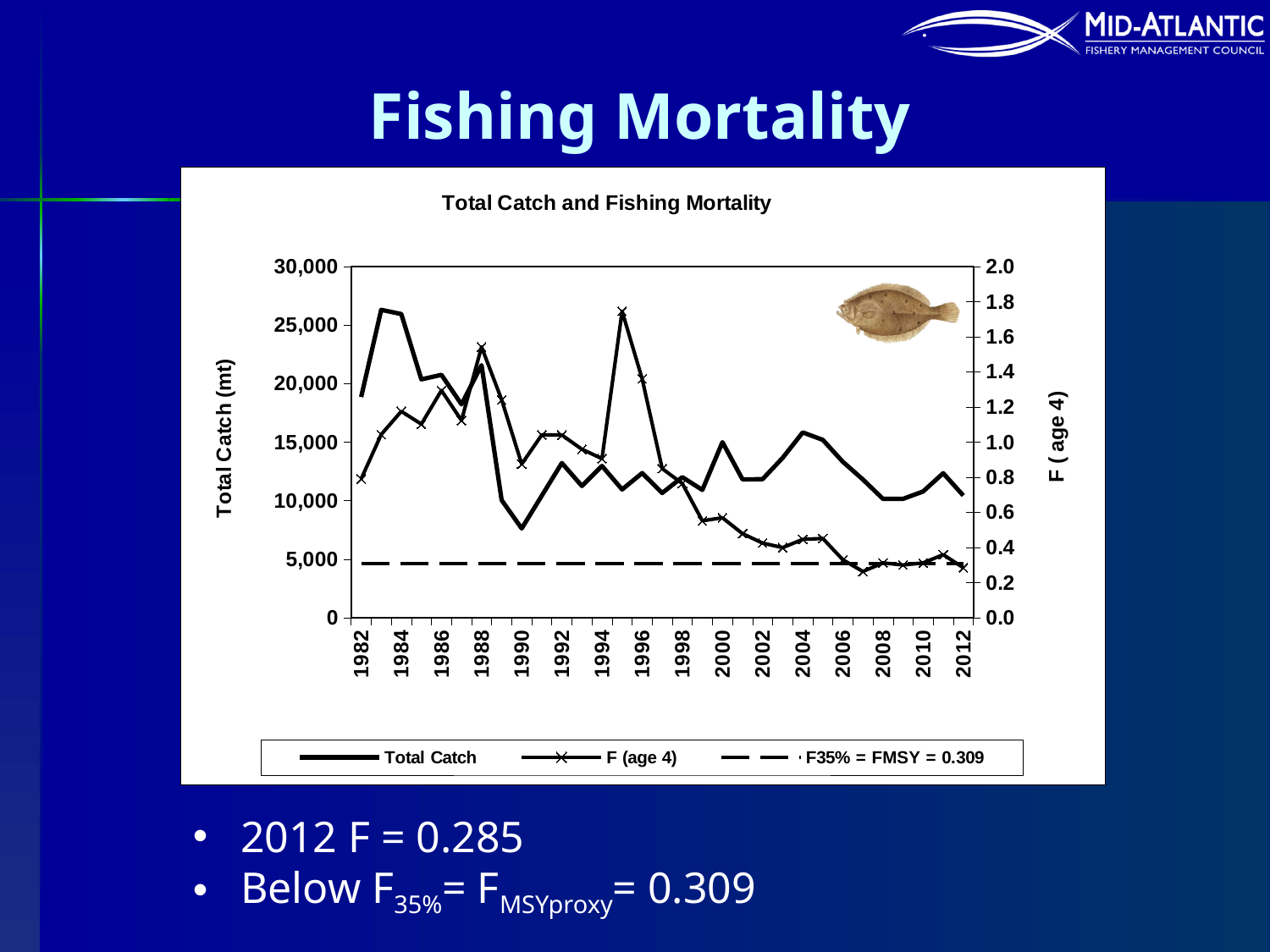
Is the F (age 4) value for 1995 greater or less than 1.6? greater What is the label of the left vertical axis? Total Catch (mt) In which year does F (age 4) reach its highest value? 1995 In which year is Total Catch at its lowest? 1990 What value does the dashed F35% = FMSY reference line represent? 0.309 Does F (age 4) generally rise or fall from 1999 to 2012? fall According to the slide, what is the F value for 2012? 0.285 Is the Total Catch value for 1983 greater or less than 25,000? greater What is the title of the chart? Total Catch and Fishing Mortality How many series does the chart legend list? 3 What kind of chart is shown on the slide? line chart